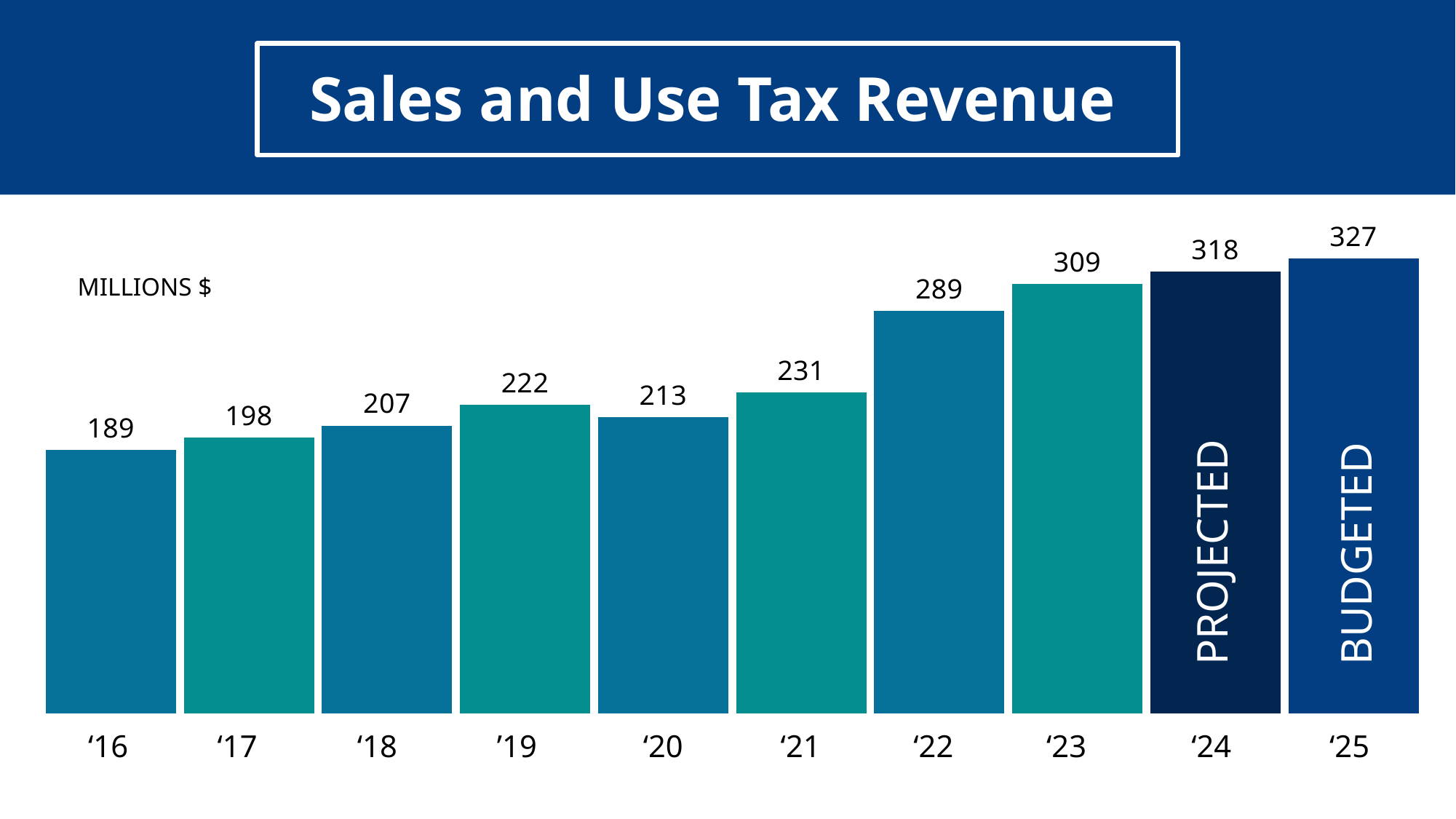
What kind of chart is used to show Sales and Use Tax Revenue? Bar chart What is the Sales and Use Tax Revenue value for '20? 213 Which year has a higher Sales and Use Tax Revenue, '19 or '20? '19 What is the difference in Sales and Use Tax Revenue between '25 and '16? 138 How many years are shown in the Sales and Use Tax Revenue chart? 10 In what unit are the Sales and Use Tax Revenue values shown? Millions $ What is the projected Sales and Use Tax Revenue for '24? 318 What is the Sales and Use Tax Revenue value for '16? 189 Which year has the highest Sales and Use Tax Revenue? '25 Which year has the lowest Sales and Use Tax Revenue? '16 What is the budgeted Sales and Use Tax Revenue for '25? 327 What is the difference in Sales and Use Tax Revenue between '23 and '22? 20